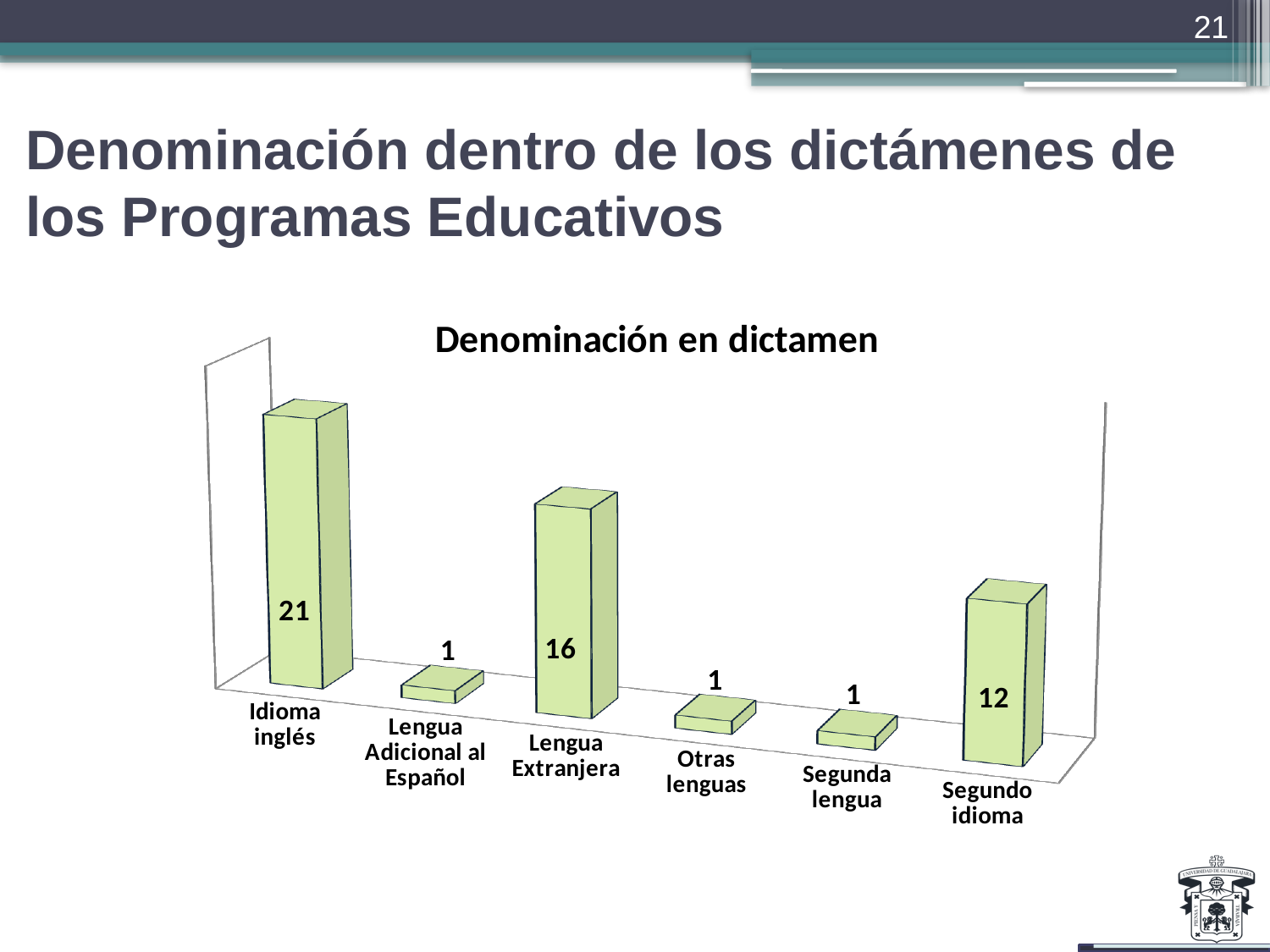
How many categories have a value of 1? 3 What is the value for Idioma inglés? 21 What is the difference between the values for Idioma inglés and Lengua Extranjera? 5 How many categories are shown on the x axis? 6 What is the value for Lengua Extranjera? 16 What is the difference between the values for Lengua Extranjera and Segundo idioma? 4 What is the value for Otras lenguas? 1 What is the title of the chart? Denominación en dictamen Which is larger, the value for Segundo idioma or the value for Lengua Extranjera? Lengua Extranjera What is the value for Segundo idioma? 12 What kind of chart is shown on the slide? Bar chart Which category has the highest value? Idioma inglés